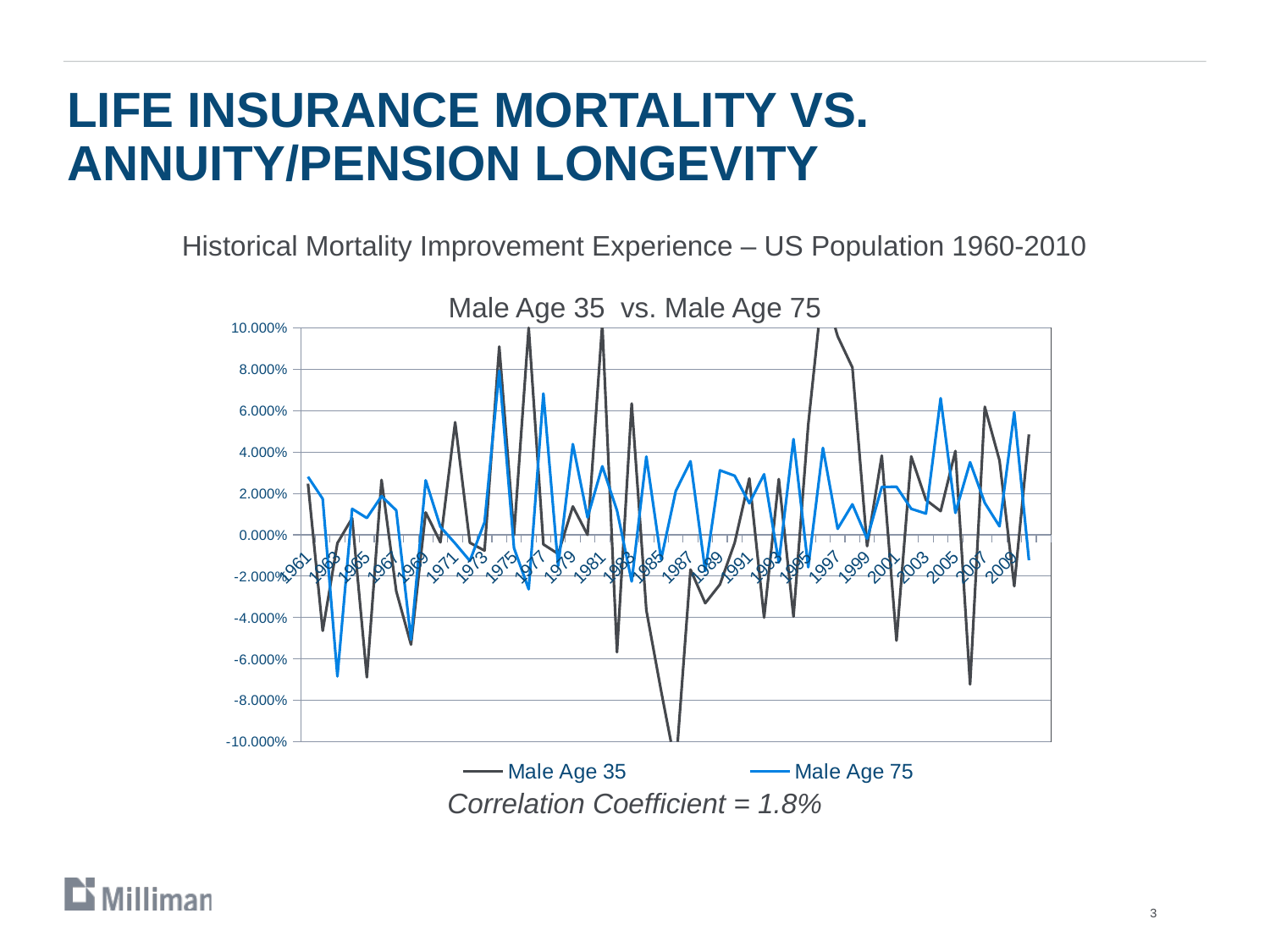
Does the Male Age 35 series ever fall below -8.000% on the chart? yes What is the highest value shown on the chart's vertical axis? 10.000% Does the Male Age 75 series ever fall below -8.000% on the chart? no What are the two series named in the chart legend? Male Age 35 and Male Age 75 How many year labels appear on the chart's horizontal axis? 25 What is the lowest value shown on the chart's vertical axis? -10.000% What kind of chart is shown on the slide? line chart What is the title of the chart? Male Age 35 vs. Male Age 75 How many series does the chart legend list? 2 What is the last year labeled on the chart's horizontal axis? 2009 Which series reaches the highest value on the chart, Male Age 35 or Male Age 75? Male Age 35 What is the first year labeled on the chart's horizontal axis? 1961